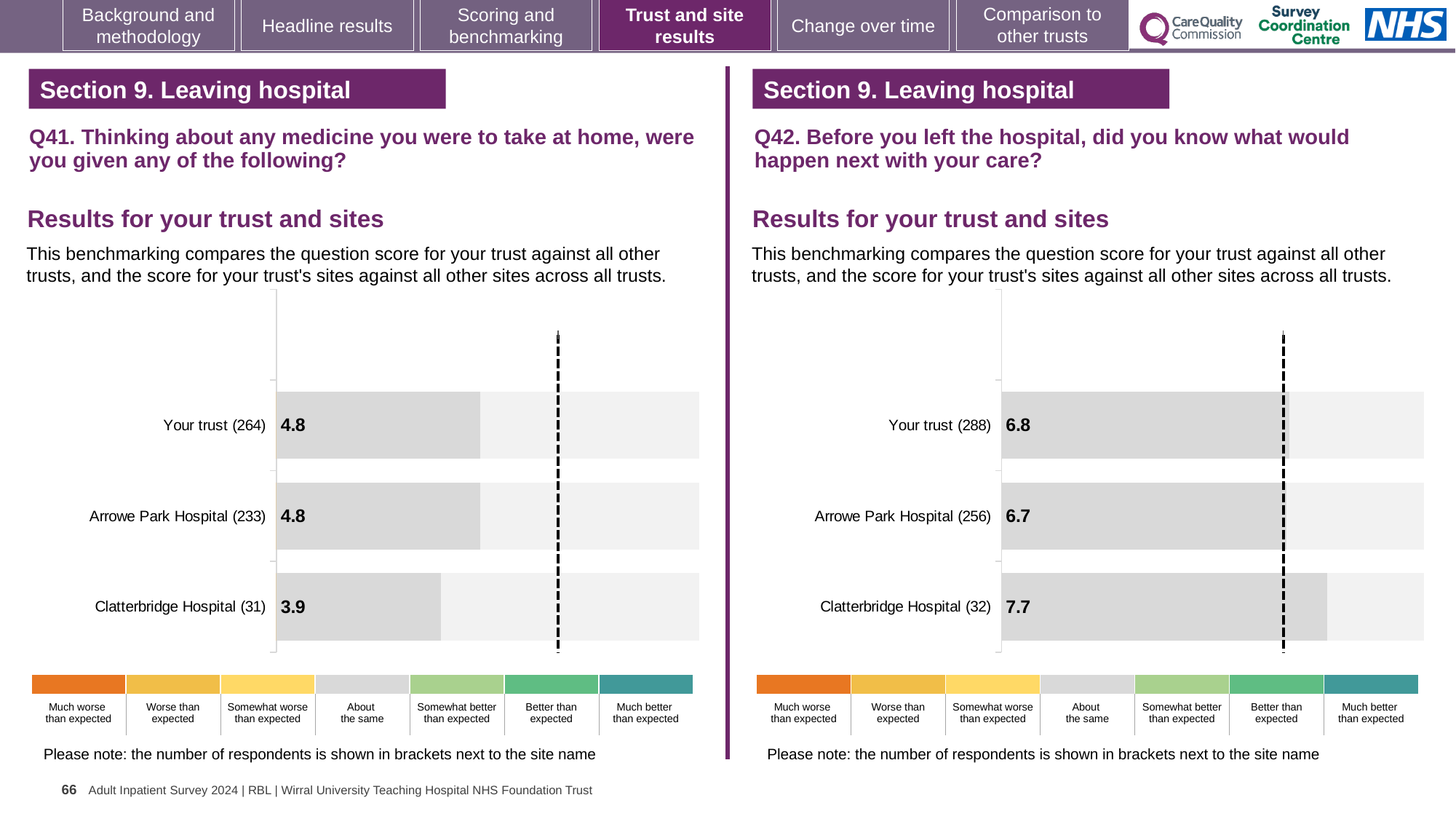
In the Q42 chart on the right, what is the difference between the scores for Clatterbridge Hospital and Your trust? 0.9 In the Q41 chart on the left, what is the score for Your trust? 4.8 How many sites (bars) are shown in the Q41 chart on the left? 3 In the Q42 chart on the right, what is the score for Clatterbridge Hospital? 7.7 In the Q41 chart on the left, how many respondents are shown in brackets for Your trust? 264 In the Q42 chart on the right, what is the score for Arrowe Park Hospital? 6.7 In the Q41 chart on the left, what is the score for Clatterbridge Hospital? 3.9 In the Q41 chart on the left, which site has the lowest score? Clatterbridge Hospital What type of chart is used in the Q42 chart on the right? bar chart In the Q42 chart on the right, is the score for Clatterbridge Hospital larger or smaller than the score for Arrowe Park Hospital? larger In the Q42 chart on the right, which site has the highest score? Clatterbridge Hospital In the Q41 chart on the left, what is the difference between the scores for Arrowe Park Hospital and Clatterbridge Hospital? 0.9